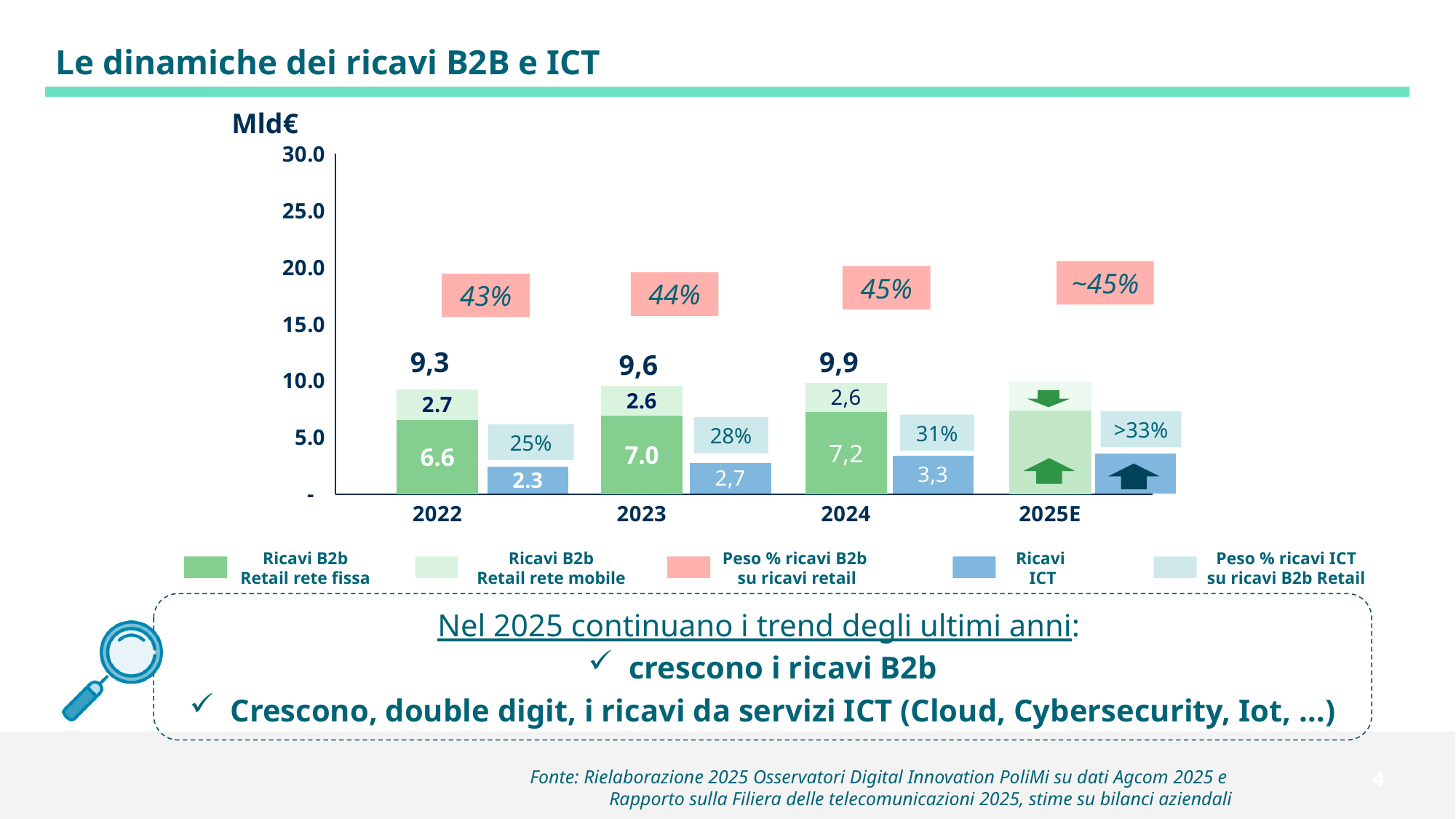
What is the total of the stacked B2b Retail bar (rete fissa plus rete mobile) in 2023? 9,6 What is the difference between Ricavi ICT in 2024 and in 2022? 1.0 What is the Peso % ricavi ICT su ricavi B2b Retail in 2023? 28% What is the Peso % ricavi B2b su ricavi retail in 2024? 45% What is the value of Ricavi ICT in 2024? 3,3 In which year among 2022, 2023 and 2024 is Ricavi ICT highest? 2024 Is the total B2b Retail bar for 2024 greater or less than 15.0? less What kind of chart is shown on the slide? Bar chart What is the value of Ricavi B2b Retail rete fissa in 2022? 6.6 In which year among 2022, 2023 and 2024 is Ricavi B2b Retail rete fissa lowest? 2022 How many series does the legend list? 5 Which is larger in 2023: Ricavi B2b Retail rete fissa or Ricavi ICT? Ricavi B2b Retail rete fissa